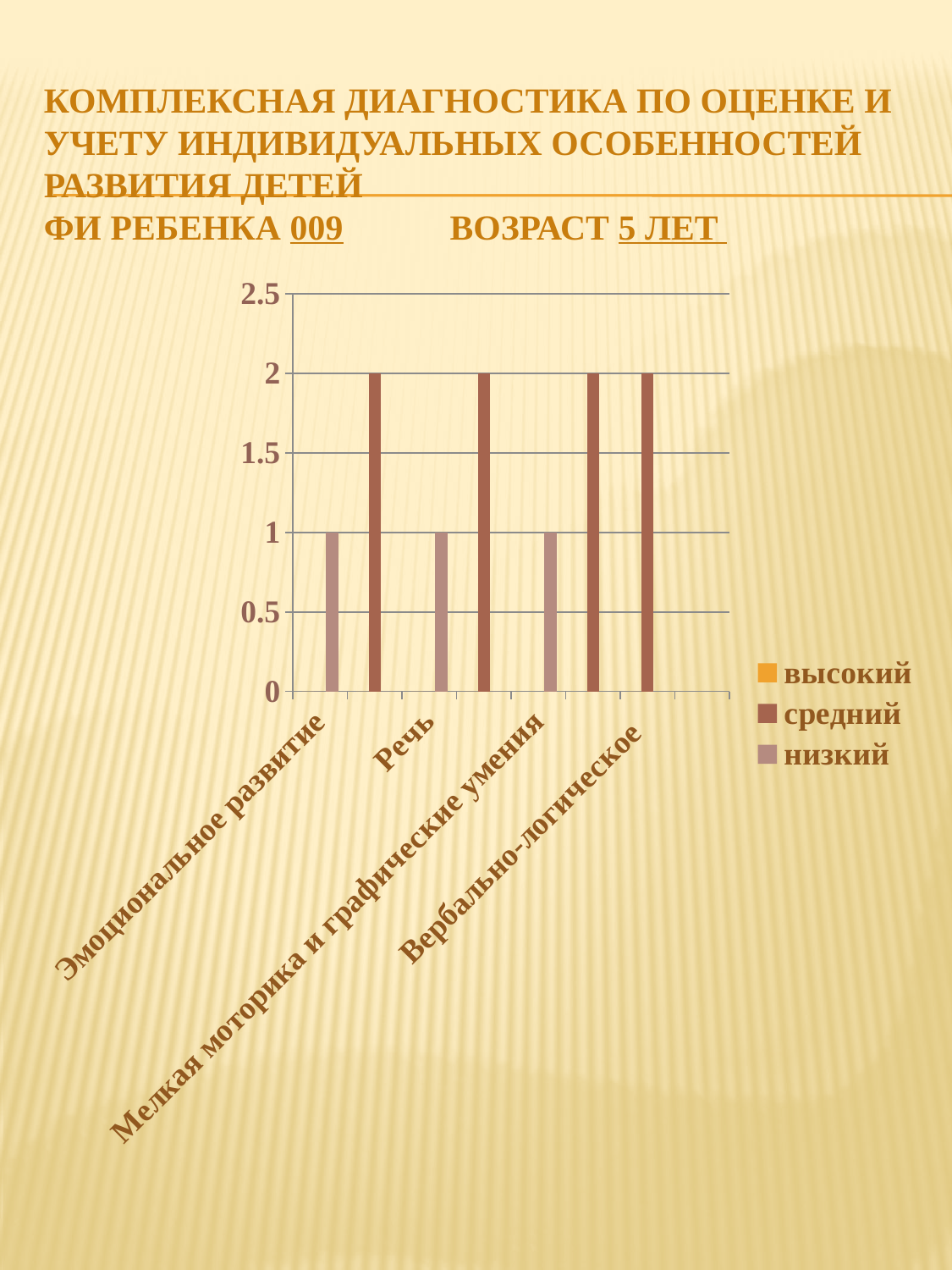
What is the highest value shown on the vertical axis? 2.5 What is the value of the средний bar for Вербально-логическое? 2 How many series does the legend list? 3 What is the value of the низкий bar for Мелкая моторика и графические умения? 1 What is the value of the низкий bar for Эмоциональное развитие? 1 What kind of chart is shown on the slide? bar chart Is the низкий bar for Речь greater or less than 1.5? less What are the three series named in the legend? высокий, средний, низкий What is the value of the низкий bar for Речь? 1 Is the средний bar for Вербально-логическое greater or less than 1.5? greater Which is larger: the средний bar for Вербально-логическое or the низкий bar for Речь? средний bar for Вербально-логическое What is the difference between the средний bar for Вербально-логическое and the низкий bar for Эмоциональное развитие? 1